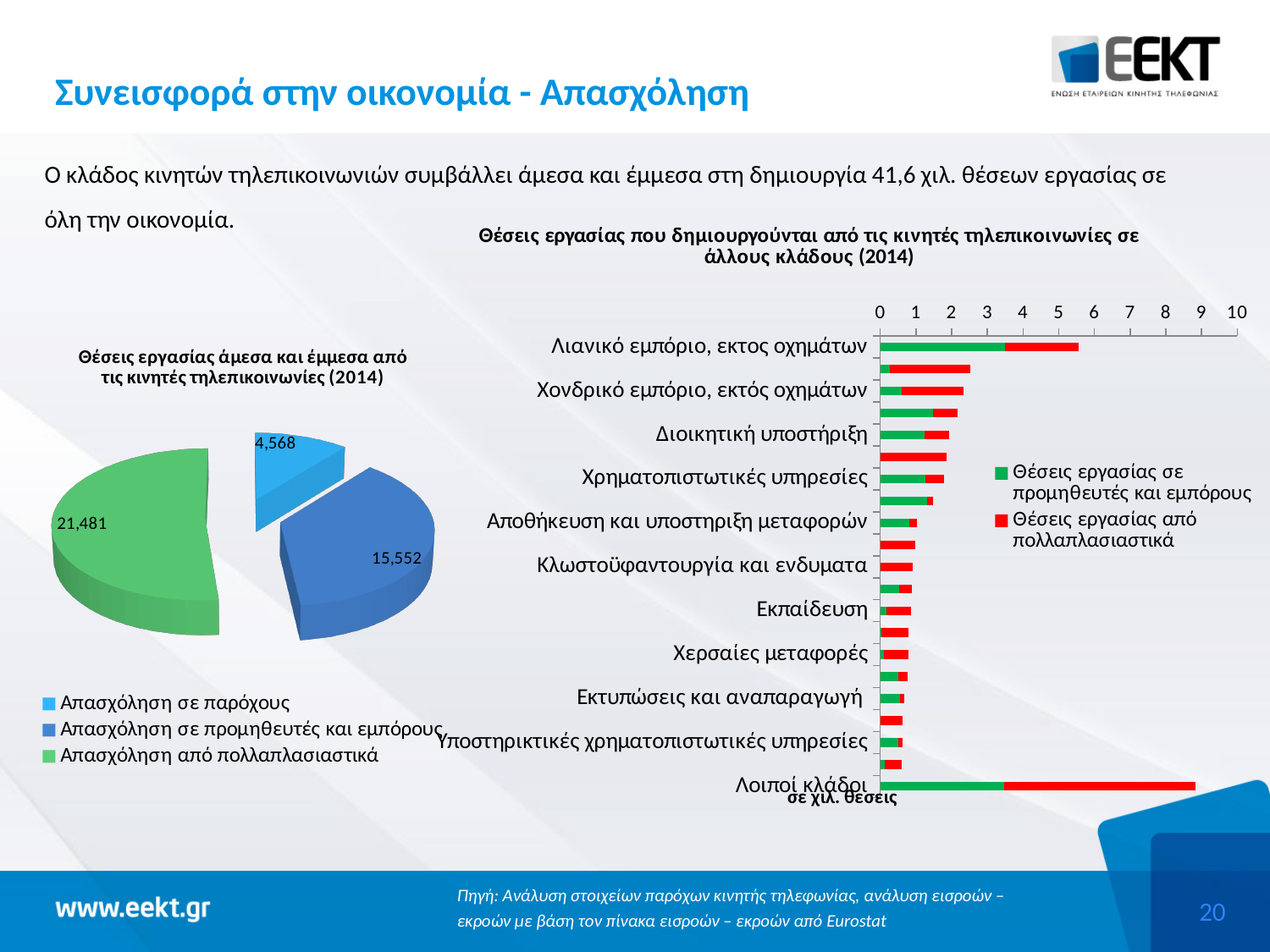
In the pie chart 'Θέσεις εργασίας άμεσα και έμμεσα από τις κινητές τηλεπικοινωνίες (2014)', what is the value for 'Απασχόληση από πολλαπλασιαστικά'? 21,481 In the pie chart on the left, which category has the smallest value? Απασχόληση σε παρόχους In the pie chart 'Θέσεις εργασίας άμεσα και έμμεσα από τις κινητές τηλεπικοινωνίες (2014)', what is the value for 'Απασχόληση σε παρόχους'? 4,568 In the pie chart on the left, what is the difference between 'Απασχόληση από πολλαπλασιαστικά' and 'Απασχόληση σε προμηθευτές και εμπόρους'? 5,929 In the bar chart on the right, is the total value for 'Εκπαίδευση' greater or less than 2? less What kind of chart is the chart on the left of the slide? Pie chart What kind of chart is 'Θέσεις εργασίας που δημιουργούνται από τις κινητές τηλεπικοινωνίες σε άλλους κλάδους (2014)'? Bar chart In the pie chart on the left, how many categories does the legend list? 3 In the bar chart 'Θέσεις εργασίας που δημιουργούνται από τις κινητές τηλεπικοινωνίες σε άλλους κλάδους (2014)', how many series does the legend list? 2 In the pie chart on the left, which is larger: 'Απασχόληση σε προμηθευτές και εμπόρους' or 'Απασχόληση σε παρόχους'? Απασχόληση σε προμηθευτές και εμπόρους In the bar chart on the right, is the total value for 'Λοιποί κλάδοι' greater or less than 7? greater In the pie chart on the left, which category has the largest value? Απασχόληση από πολλαπλασιαστικά